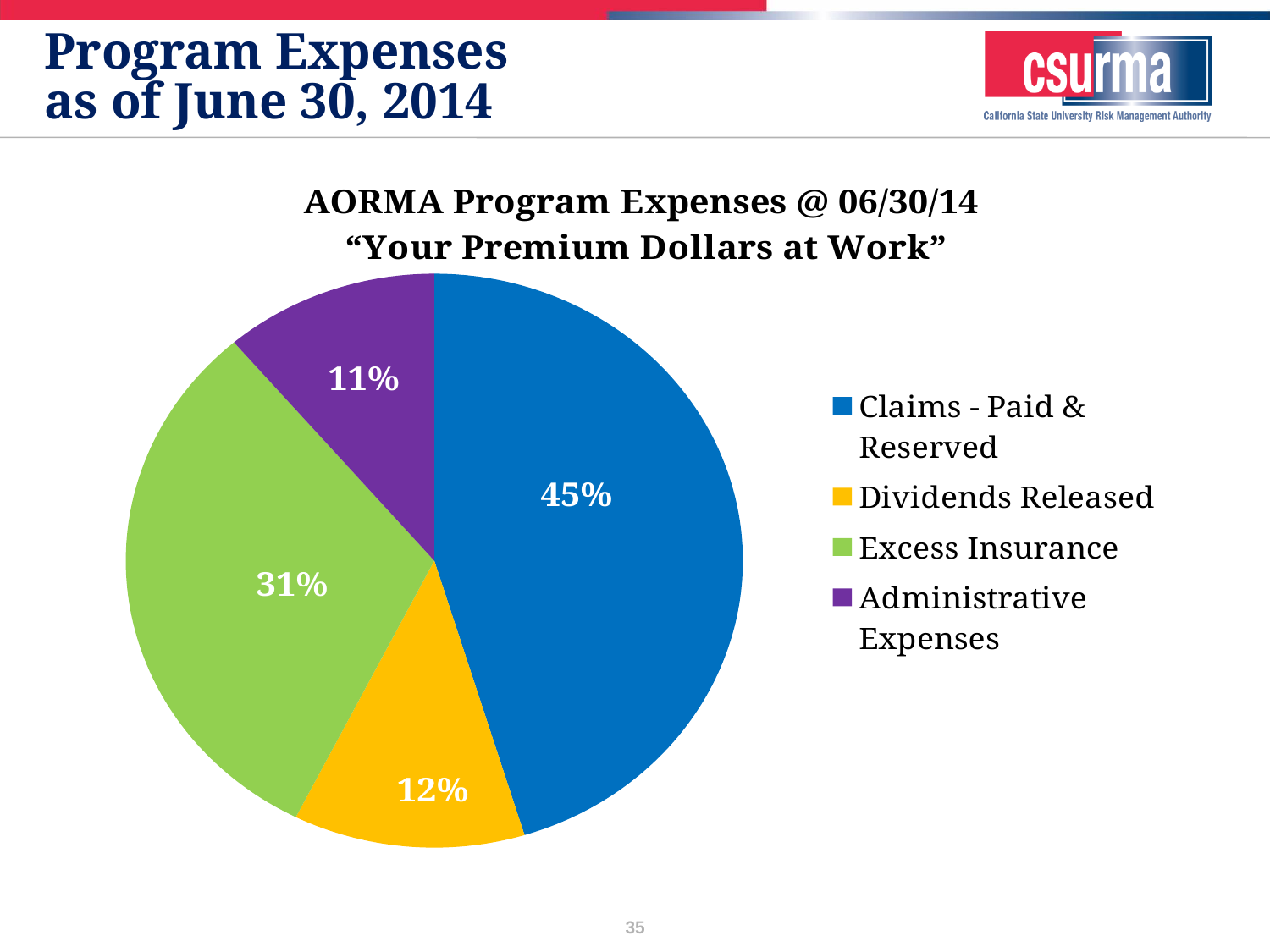
What share of AORMA program expenses is Claims - Paid & Reserved? 45% Which category has the largest share of the pie? Claims - Paid & Reserved Which is larger, the share for Excess Insurance or the share for Dividends Released? Excess Insurance What type of chart is shown on the slide? pie chart What colour is the Excess Insurance slice? green How many slices does the pie chart have? 4 What is the difference in percentage points between Claims - Paid & Reserved and Excess Insurance? 14 What share of AORMA program expenses is Administrative Expenses? 11% What share of AORMA program expenses is Dividends Released? 12% Which category has the smallest share of the pie? Administrative Expenses What is the title of the chart? AORMA Program Expenses @ 06/30/14 "Your Premium Dollars at Work"